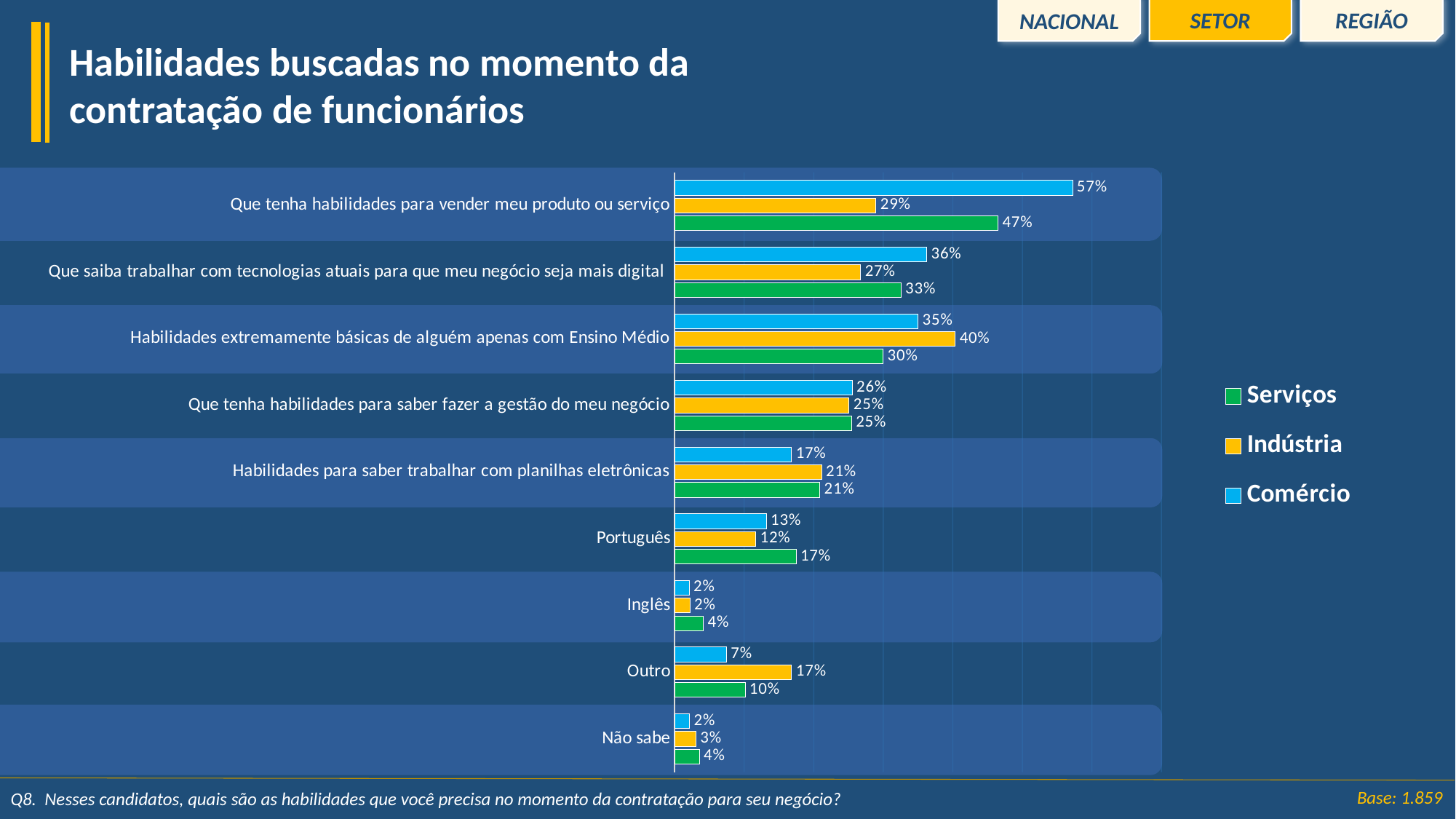
How many series does the legend list? 3 What is the Indústria value for "Outro"? 17% What is the Comércio value for "Que tenha habilidades para vender meu produto ou serviço"? 57% What kind of chart is shown on the slide? Bar chart Which series is shown in green in the legend? Serviços What is the difference between the Comércio and Indústria values for "Que tenha habilidades para vender meu produto ou serviço"? 28% What is the Indústria value for "Habilidades extremamente básicas de alguém apenas com Ensino Médio"? 40% What is the Serviços value for "Português"? 17% Which category has the highest Comércio value? Que tenha habilidades para vender meu produto ou serviço For "Habilidades extremamente básicas de alguém apenas com Ensino Médio", which is larger: the Indústria value or the Serviços value? Indústria How many categories are shown in the chart? 9 Which category has the lowest Indústria value? Inglês